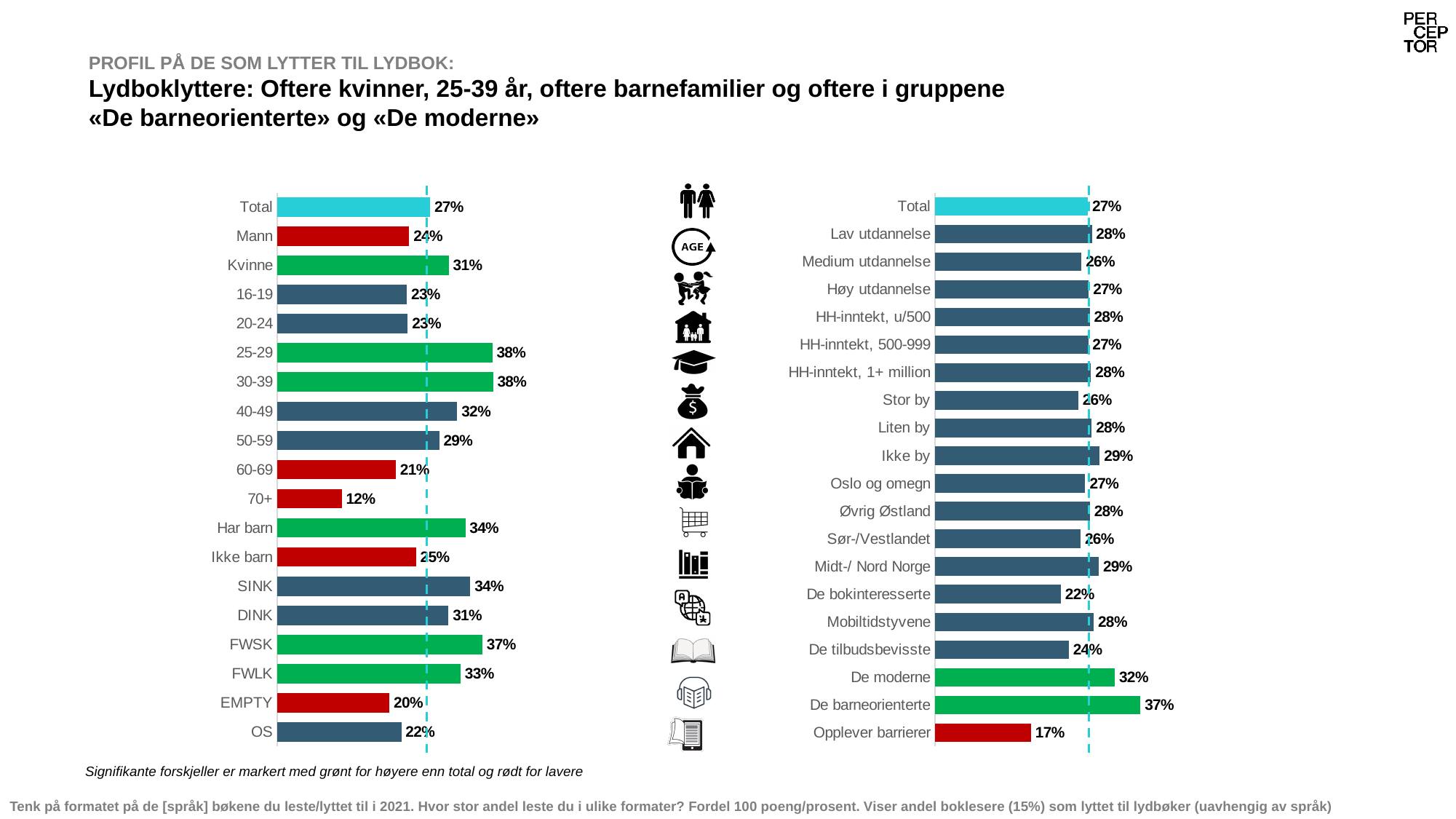
In the right chart, what is the value for De barneorienterte? 37% In the left chart, what is the value for Kvinne? 31% In the right chart, which category has the lowest value? Opplever barrierer In the right chart, what is the difference between De moderne and De bokinteresserte? 10% In the right chart, how many categories are plotted? 20 In the left chart, what is the value for 70+? 12% In the left chart, which is larger, Har barn or Ikke barn? Har barn What kind of chart is the left chart? Bar chart In the left chart, what is the value for Total? 27% In the left chart, which category has the lowest value? 70+ In the left chart, what is the difference between Kvinne and Mann? 7% In the right chart, which category has the highest value? De barneorienterte